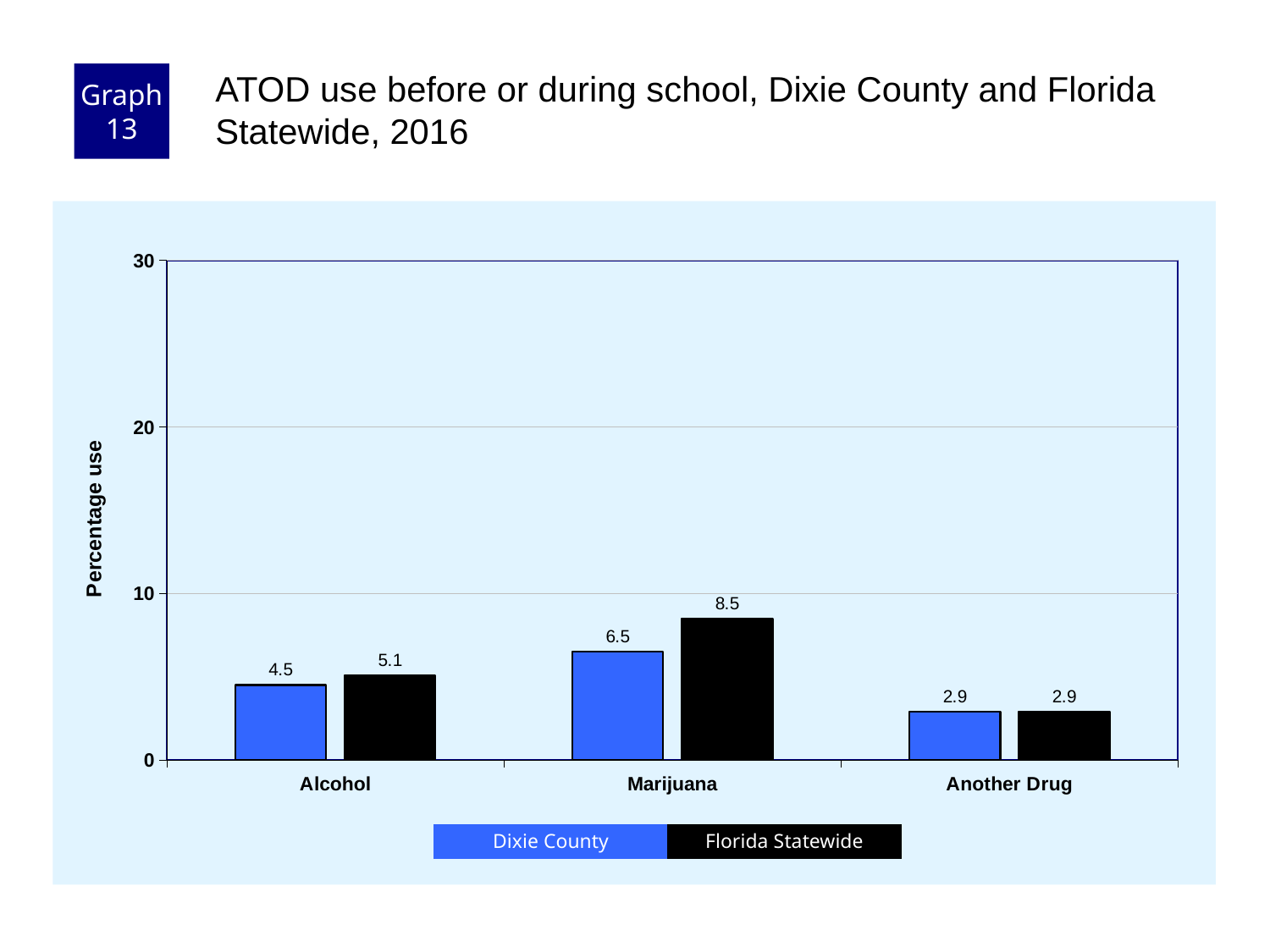
What kind of chart is shown on the slide? bar chart What is the Florida Statewide value for Marijuana? 8.5 Which category has the lowest Dixie County value? Another Drug What is the label of the y axis? Percentage use What is the difference between the Florida Statewide and Dixie County values for Marijuana? 2.0 How many series does the legend list? 2 Which is larger for Alcohol, the Dixie County value or the Florida Statewide value? Florida Statewide How many categories are shown on the x axis? 3 Is the Florida Statewide value for Marijuana greater or less than 10? less What is the Dixie County value for Another Drug? 2.9 Which category has the highest Florida Statewide value? Marijuana What is the Dixie County value for Alcohol? 4.5